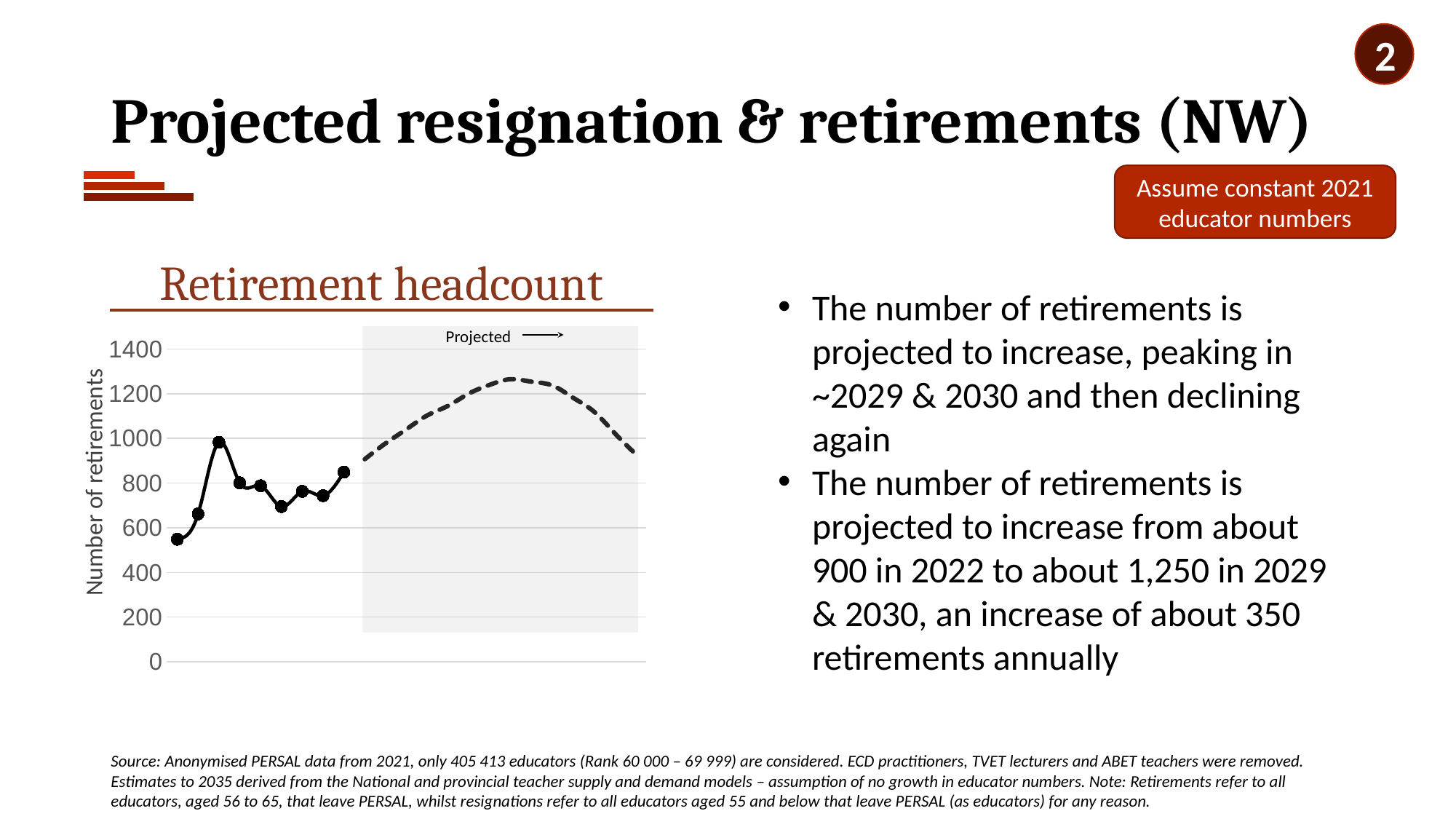
Is the peak of the dashed projected line on the Retirement headcount chart greater or less than 1200? greater What kind of chart is the Retirement headcount chart? line chart Is the last solid data point on the Retirement headcount chart higher or lower than the first solid data point? higher Does the dashed projected line on the Retirement headcount chart rise and then fall, or fall and then rise? rise and then fall Is the highest point of the solid line on the Retirement headcount chart greater or less than 800? greater Is the first plotted value on the Retirement headcount chart greater or less than 600? less What is the title of the chart on the slide? Retirement headcount How many solid (historical) data points are plotted on the Retirement headcount chart? 9 What is the highest tick value shown on the vertical axis of the Retirement headcount chart? 1400 What is the label on the vertical axis of the Retirement headcount chart? Number of retirements